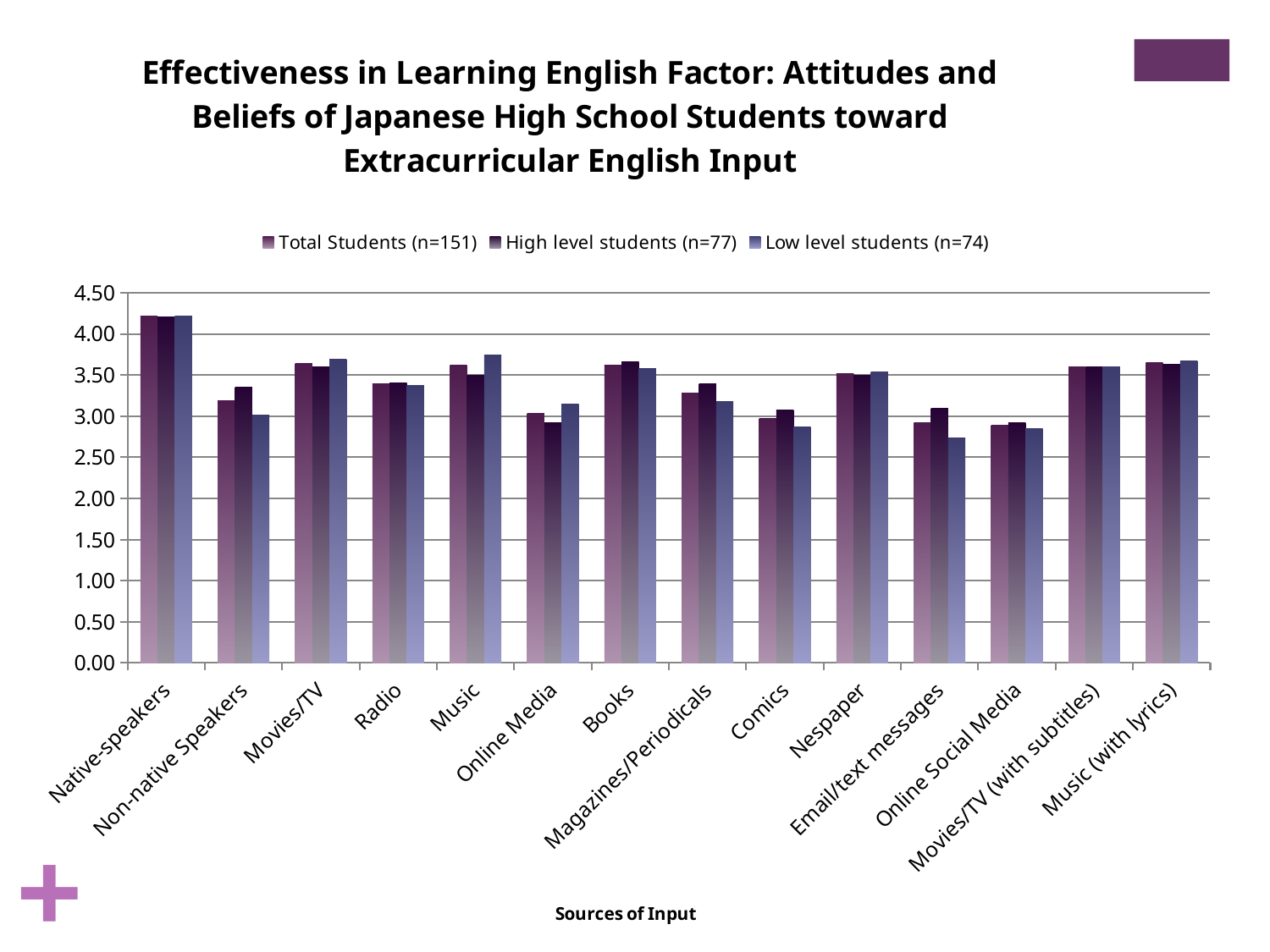
How many sources of input are shown along the x axis? 14 For Music, which group has the larger value: High level students (n=77) or Low level students (n=74)? Low level students (n=74) What is the title of the x axis? Sources of Input Which source of input has the highest value for Total Students (n=151)? Native-speakers For Email/text messages, which group has the larger value: High level students (n=77) or Low level students (n=74)? High level students (n=77) How many series does the legend list? 3 Is the value for Music for Low level students (n=74) greater or less than 3.50? greater Is the value for Radio for Total Students (n=151) greater or less than 3.50? less What kind of chart is shown on the slide? bar chart Which source of input has the lowest value for Low level students (n=74)? Email/text messages Is the value for Native-speakers for Total Students (n=151) greater or less than 4.00? greater